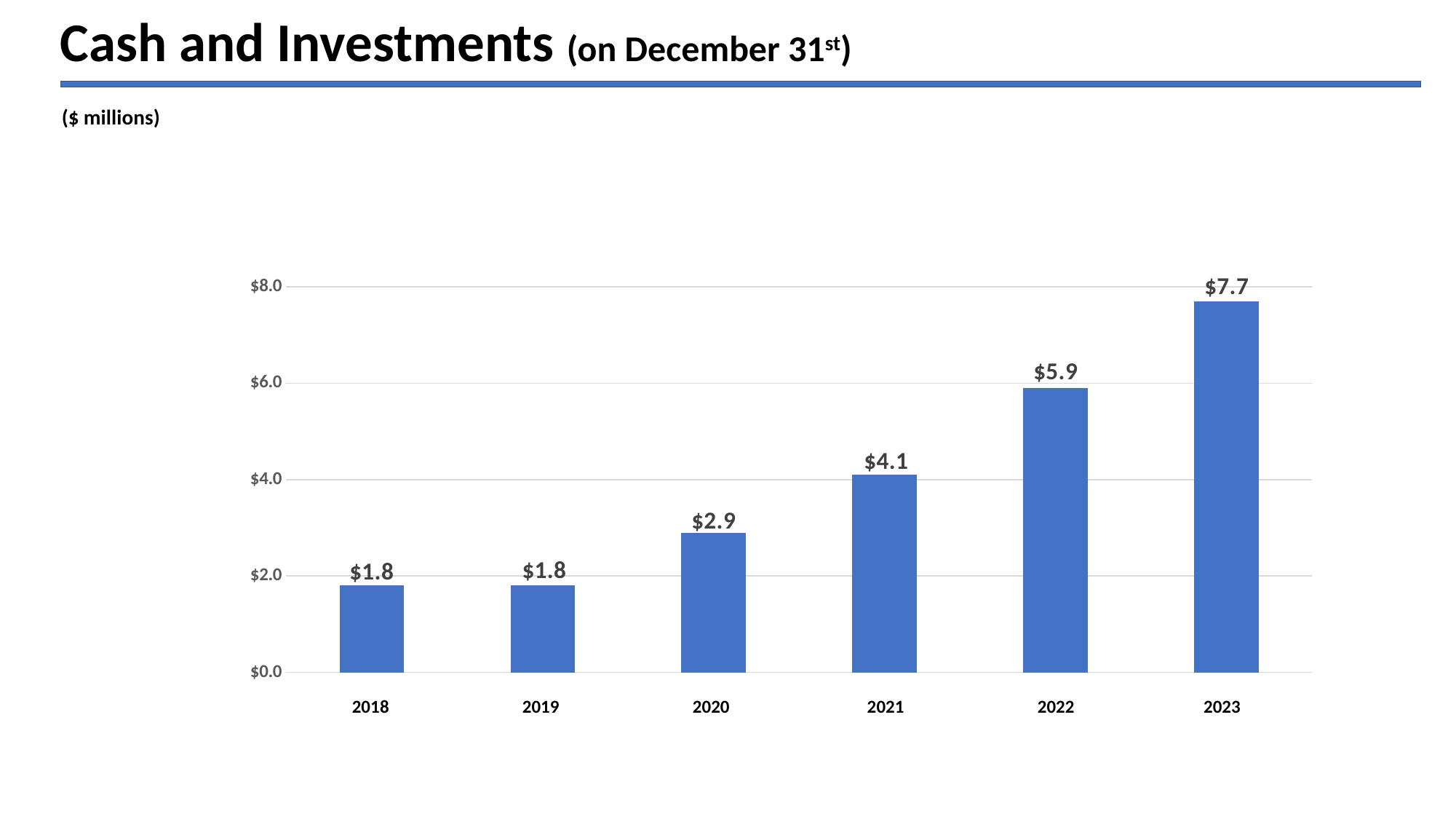
Do the values generally rise or fall from 2018 to 2023? rise Which is larger, the value for 2022 or the value for 2021? 2022 What is the value for 2023? $7.7 What is the value for 2021? $4.1 In what units are the values on the chart expressed? $ millions What is the difference between the values for 2023 and 2022? $1.8 What is the difference between the values for 2021 and 2020? $1.2 Which year has the highest value? 2023 What kind of chart is shown on the slide? bar chart How many years are shown on the x axis? 6 Is the value for 2022 greater or less than $4.0? greater What is the value for 2020? $2.9